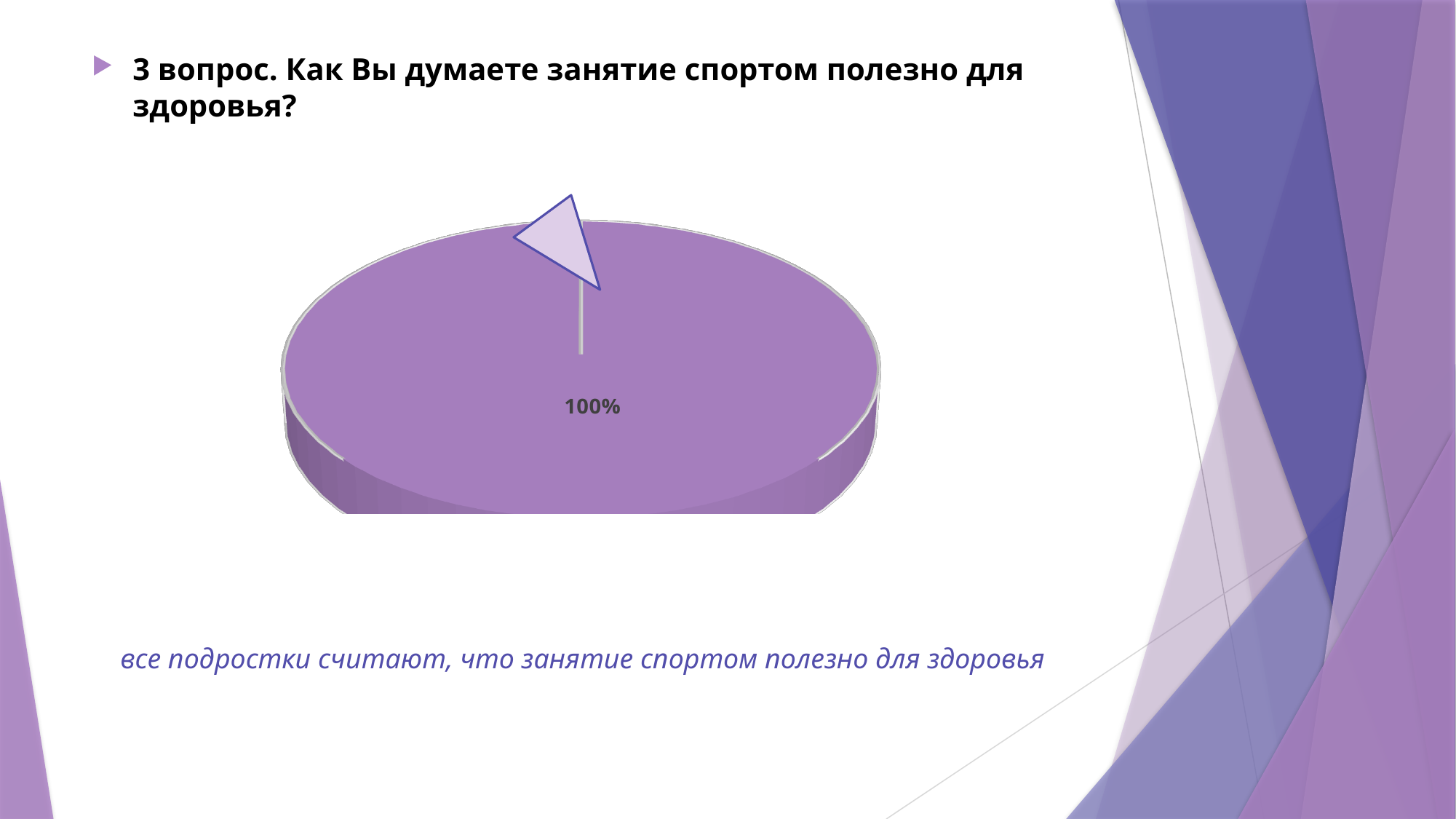
What colour is the slice of the pie chart? purple Is the value shown on the pie chart greater or less than 50%? greater Does the pie chart have a legend? No How many slices does the pie chart have? 1 What percentage is printed on the pie chart? 100% What kind of chart is shown on the slide? pie chart What share of the pie does the single slice take up? 100%